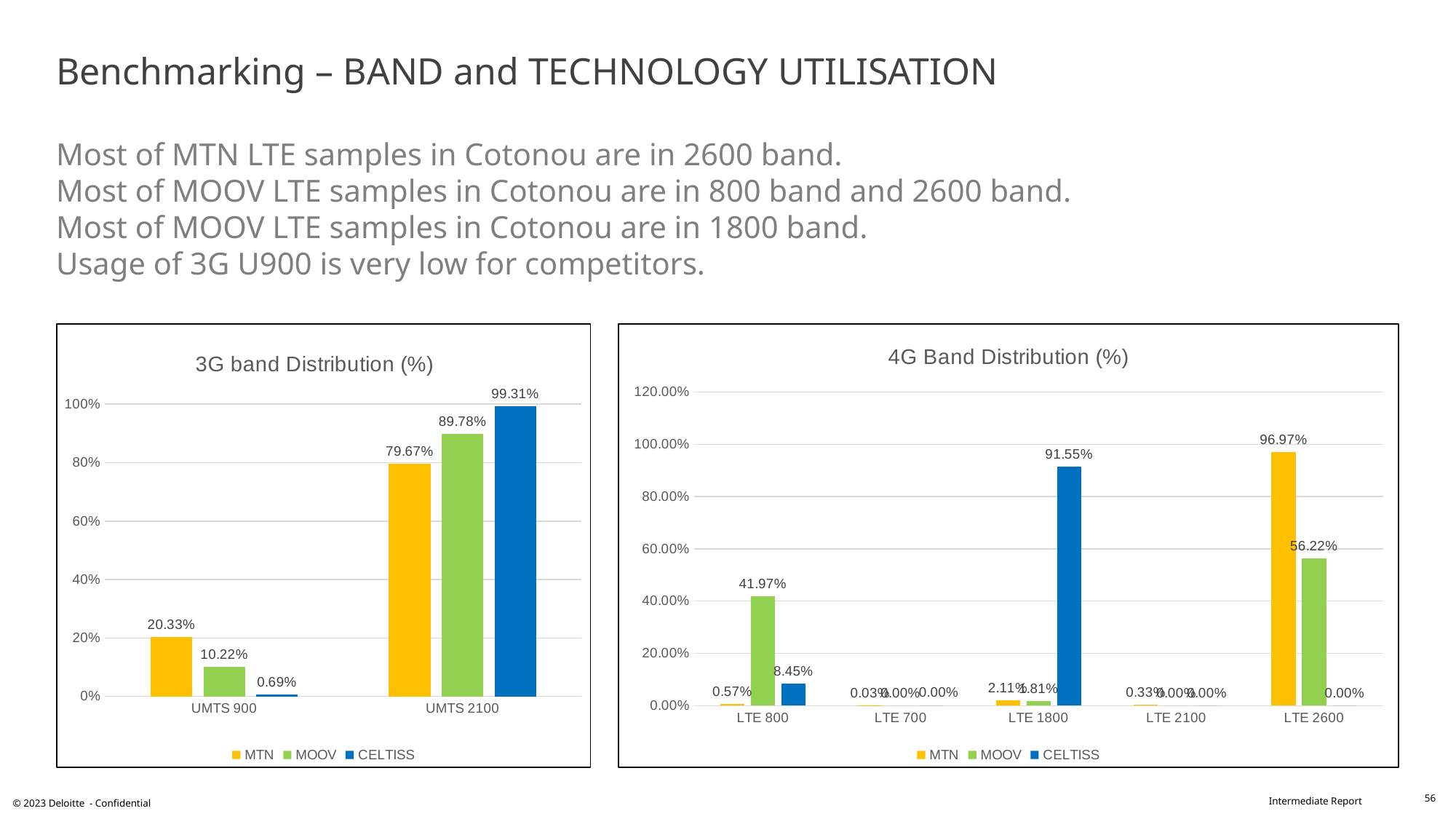
In the 3G band Distribution (%) chart, what is the value for MTN at UMTS 900? 20.33% In the 3G band Distribution (%) chart, what is the difference between MOOV's values at UMTS 2100 and UMTS 900? 79.56% In the 4G Band Distribution (%) chart, what is the value for MOOV at LTE 800? 41.97% What type of chart is the 4G Band Distribution (%) chart? Bar chart In the 4G Band Distribution (%) chart, which operator has the highest value at LTE 2600? MTN In the 4G Band Distribution (%) chart, what is the value for CELTISS at LTE 1800? 91.55% In the 4G Band Distribution (%) chart, is MTN's value at LTE 2600 larger or smaller than MOOV's value at LTE 2600? larger In the 3G band Distribution (%) chart, which operator has the lowest value at UMTS 900? CELTISS In the 4G Band Distribution (%) chart, what is the difference between MTN's and MOOV's values at LTE 2600? 40.75% How many band categories are shown on the x axis of the 4G Band Distribution (%) chart? 5 In the 3G band Distribution (%) chart, what is the value for CELTISS at UMTS 2100? 99.31% In the 3G band Distribution (%) chart, how many series does the legend list? 3